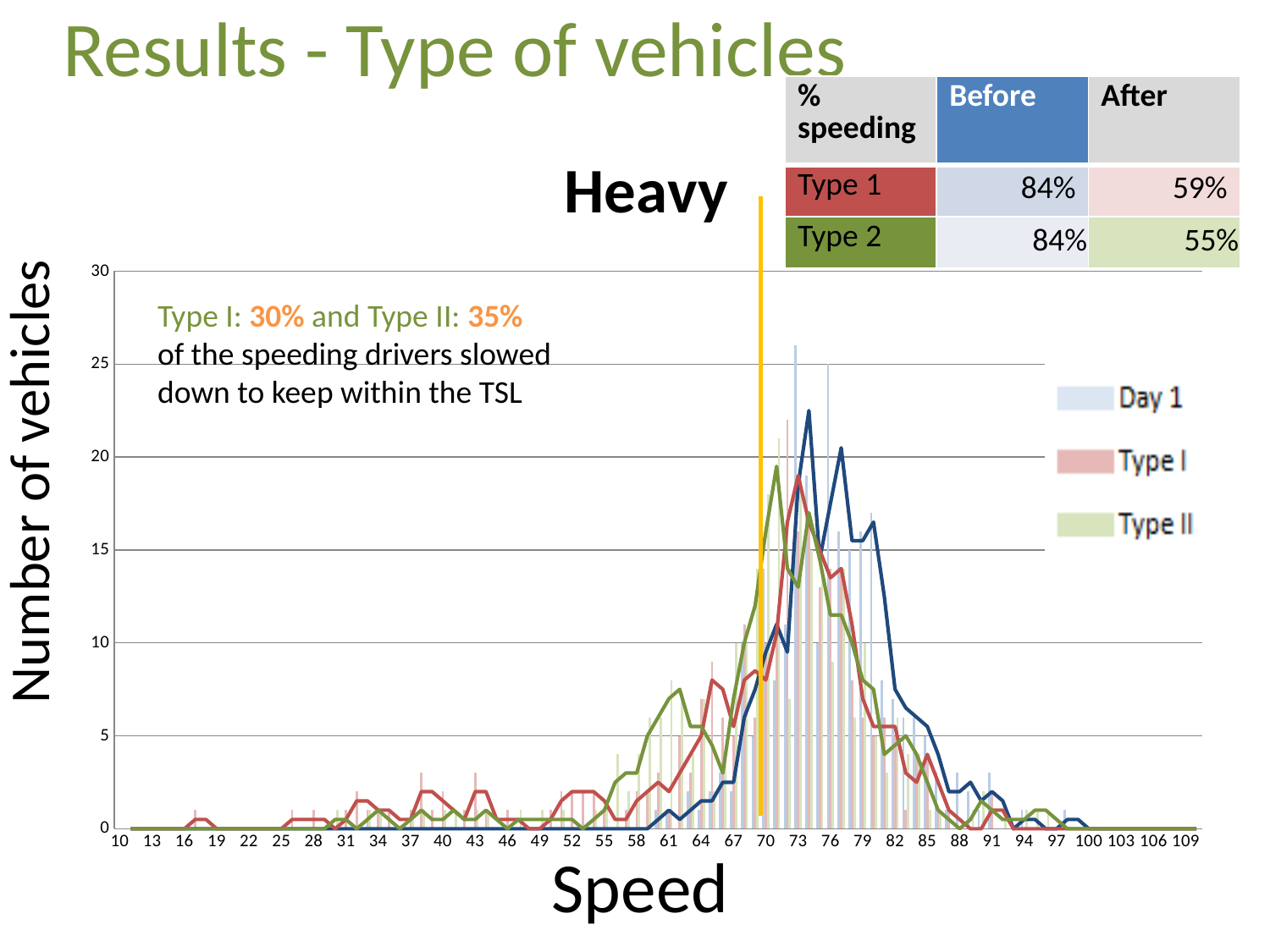
What is the highest value shown on the vertical axis of the chart? 30 What are the series names listed in the chart legend? Day 1, Type I, Type II Is the value of the Type II line at speed 61 greater or less than 5? greater Is the value of the Type II line at speed 70 greater or less than 15? greater At speed 73, which line is higher, Day 1 or Type I? Day 1 How many series does the legend of the chart list? 3 What is the last speed value shown on the horizontal axis of the chart? 109 Which series reaches the highest peak on the chart? Day 1 Is the value of the Day 1 line at speed 61 greater or less than 5? less What is the first speed value shown on the horizontal axis of the chart? 10 What is the label of the vertical axis of the chart? Number of vehicles